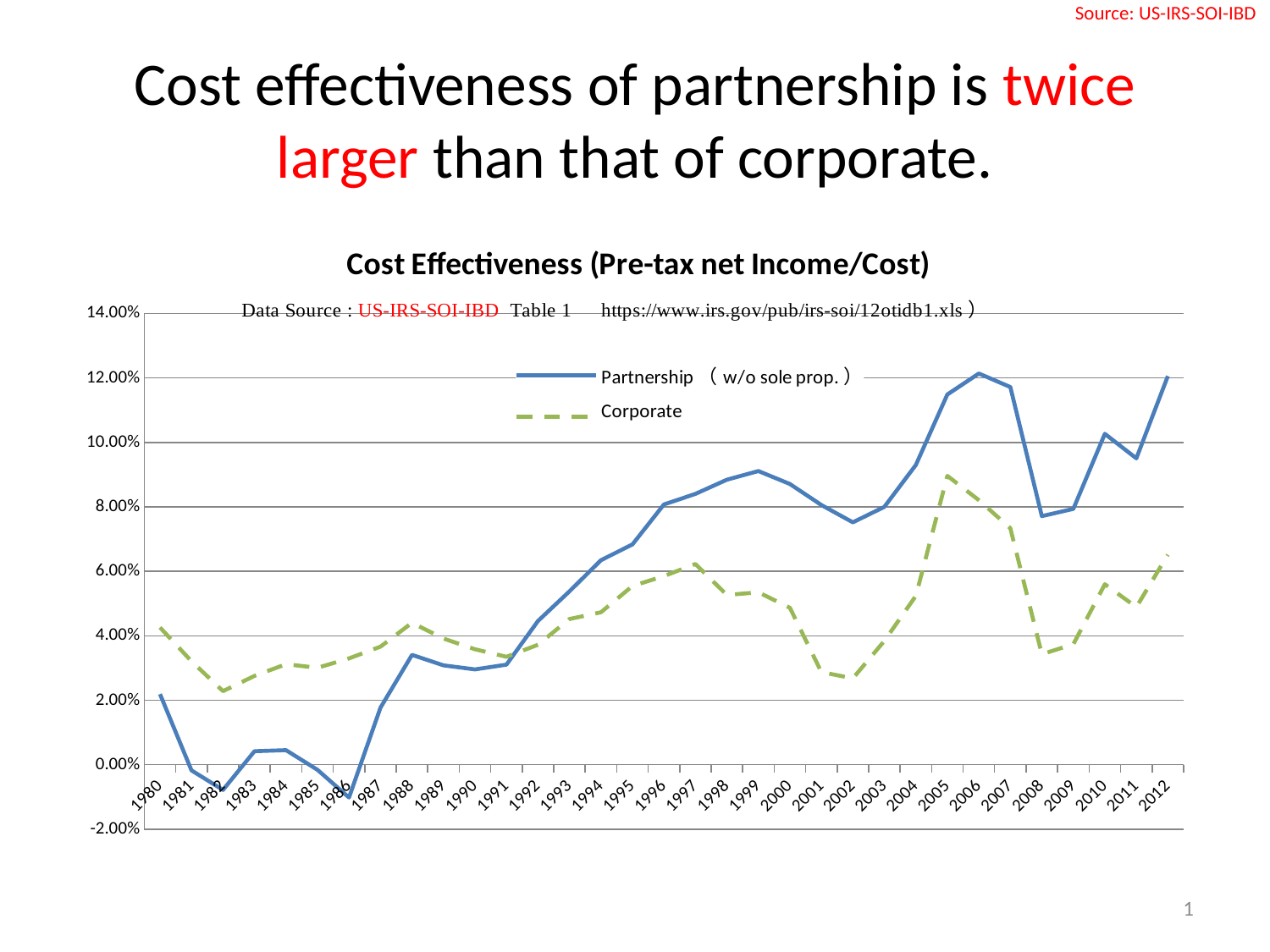
In which year does the Partnership (w/o sole prop.) series reach its highest value? 2006 How many series does the chart legend list? 2 What kind of chart is shown on the slide? line chart Which series is drawn with a dashed green line? Corporate Is the Corporate value for 2002 greater or less than 4.00%? less Is the Partnership (w/o sole prop.) value for 2012 greater or less than 10.00%? greater Does the Partnership (w/o sole prop.) series generally rise or fall between 1986 and 1999? rise How many years are plotted along the x axis of the chart? 33 Is the Partnership (w/o sole prop.) value for 1986 greater or less than 0.00%? less In 1980, which series has the higher value, Partnership (w/o sole prop.) or Corporate? Corporate In which year does the Corporate series reach its highest value? 2005 What is the title of the chart? Cost Effectiveness (Pre-tax net Income/Cost)